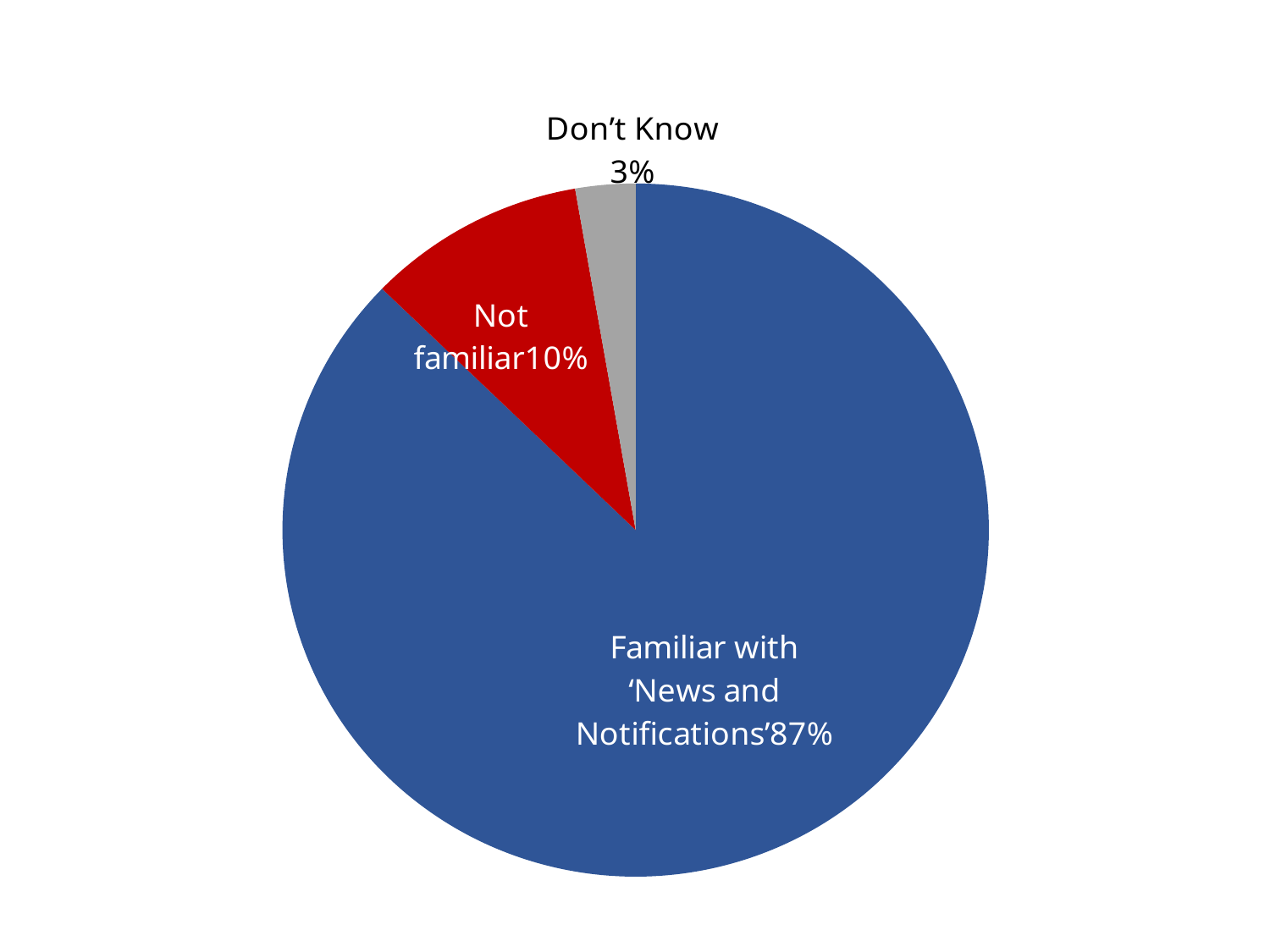
Which slice of the pie is the largest? Familiar with 'News and Notifications' How many slices does the pie chart have? 3 What kind of chart is shown on the slide? pie chart What share of the pie is labelled 'Don't Know'? 3% Which slice of the pie is the smallest? Don't Know What share of the pie is labelled 'Familiar with News and Notifications'? 87% What is the difference in percentage points between the 'Familiar with News and Notifications' slice and the 'Not familiar' slice? 77 What colour is the 'Don't Know' slice? grey What colour is the 'Not familiar' slice? red What share of the pie is labelled 'Not familiar'? 10% What is the difference in percentage points between the 'Not familiar' slice and the 'Don't Know' slice? 7 Which is larger, the 'Not familiar' slice or the 'Don't Know' slice? Not familiar